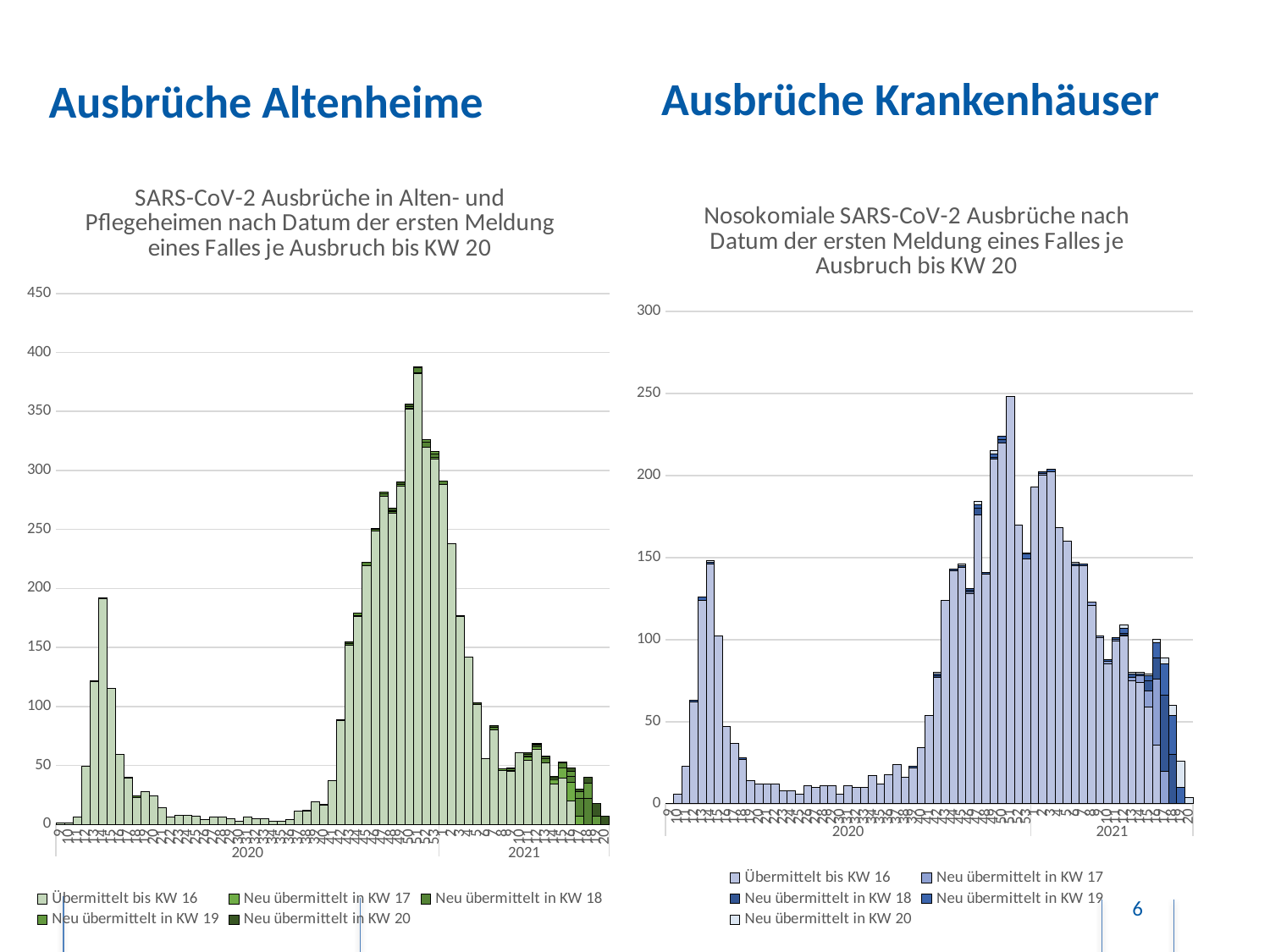
What is the first legend entry of the right chart (Krankenhäuser)? Übermittelt bis KW 16 How many series does the legend of the left chart (Altenheime) list? 5 In the right chart (Krankenhäuser), is the last bar on the x axis (KW 20 of 2021) greater or less than 50? less In the right chart (Krankenhäuser), is the tallest bar greater or less than 200? greater In the left chart (Altenheime), is the last bar on the x axis (KW 20 of 2021) greater or less than 50? less How many series does the legend of the right chart (Krankenhäuser) list? 5 Which chart has the higher peak bar, the left chart (Altenheime) or the right chart (Krankenhäuser)? The left chart (Altenheime) Which two years are labelled on the x axis of the left chart (Altenheime)? 2020 and 2021 In the right chart (Krankenhäuser), do the bars rise or fall over the final weeks of 2021 shown at the right end of the x axis? fall What kind of chart is the right chart, 'Nosokomiale SARS-CoV-2 Ausbrüche'? Stacked bar chart What kind of chart is the left chart, 'SARS-CoV-2 Ausbrüche in Alten- und Pflegeheimen'? Stacked bar chart